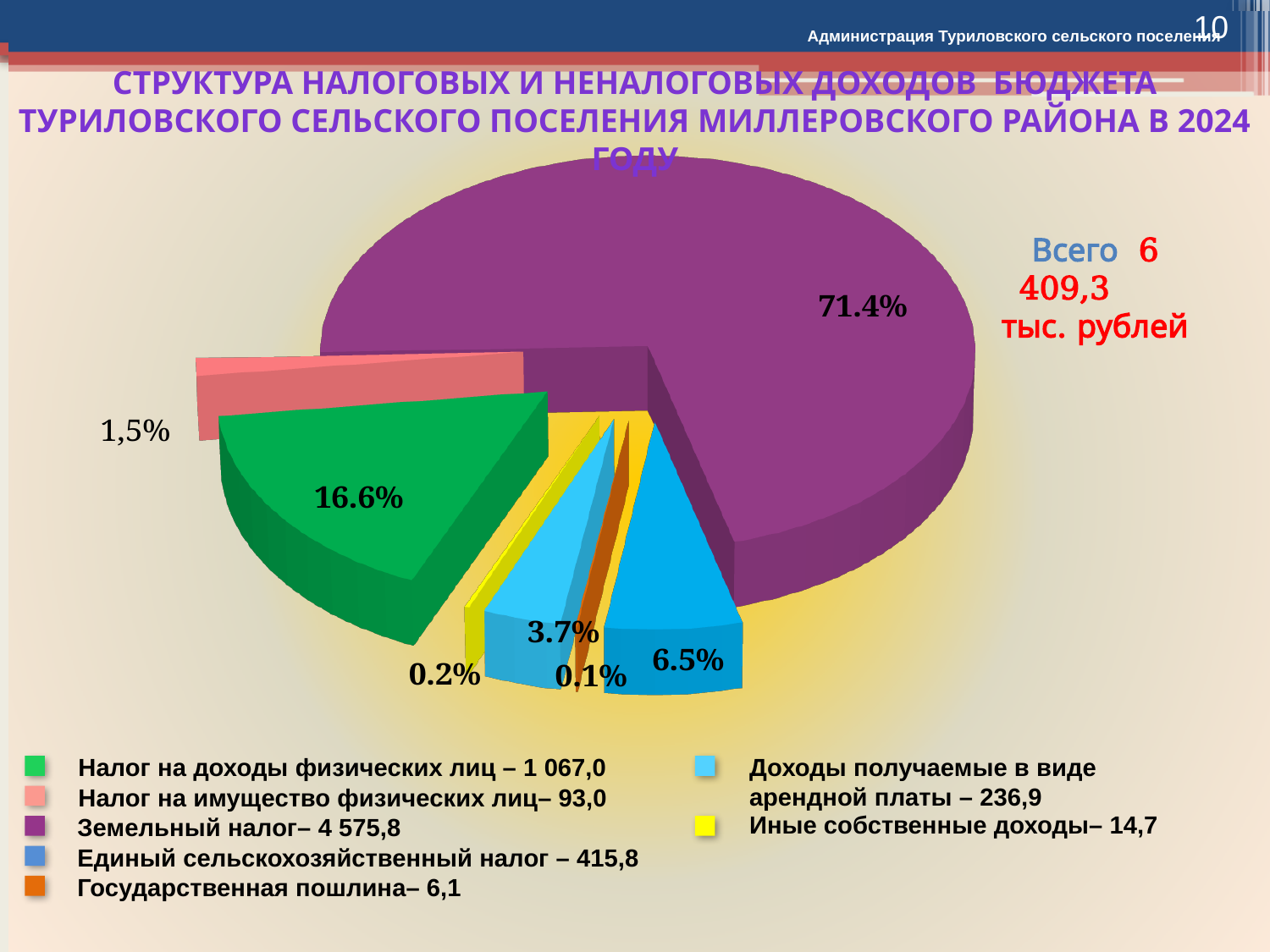
What percentage is shown for Налог на имущество физических лиц? 1,5% What is the difference in percentage points between the Земельный налог slice and the Налог на доходы физических лиц slice? 54.8 What total amount (Всего) is stated next to the pie chart? 6 409,3 тыс. рублей Which category has the smallest slice of the pie? Государственная пошлина According to the legend, what is the amount for Иные собственные доходы? 14,7 What kind of chart is shown on the slide? pie chart What share of the pie does Земельный налог account for? 71.4% According to the legend, what is the amount for Единый сельскохозяйственный налог? 415,8 Which category has the largest slice of the pie? Земельный налог What percentage is shown for Налог на доходы физических лиц? 16.6% How many slices does the pie chart have? 7 Which is larger: the share for Единый сельскохозяйственный налог or the share for Доходы получаемые в виде арендной платы? Единый сельскохозяйственный налог